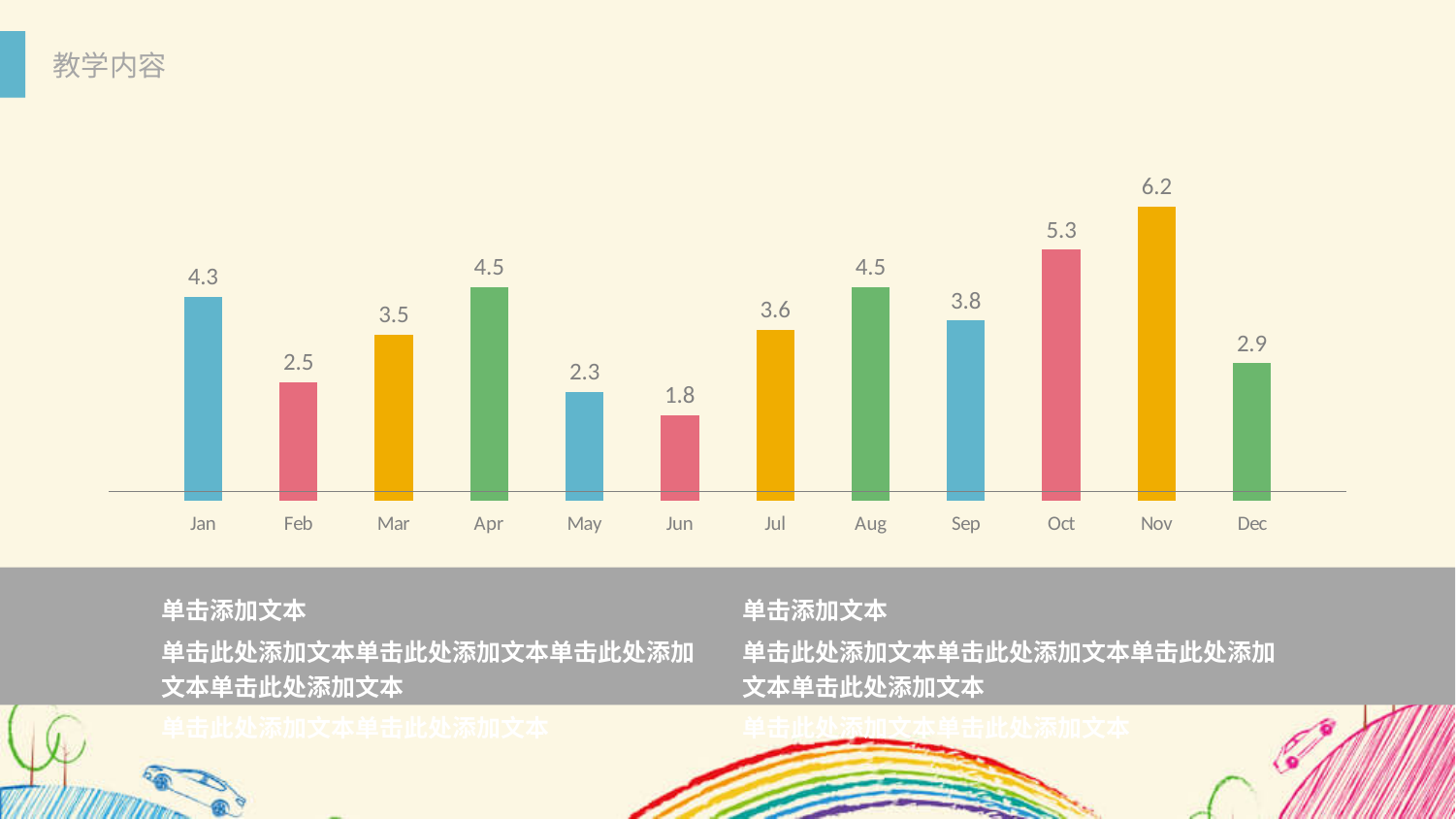
What kind of chart is shown on the slide? Bar chart How many months are shown on the x axis? 12 What is the value for Oct? 5.3 Which month has the lowest value? Jun What is the value for Nov? 6.2 What is the difference between the values for Nov and Oct? 0.9 Do the values rise or fall from Sep to Nov? Rise What is the value for Jun? 1.8 What is the difference between the values for Jan and Feb? 1.8 Which month has the highest value? Nov What is the value for Dec? 2.9 Which is larger, the value for Sep or the value for Jul? Sep